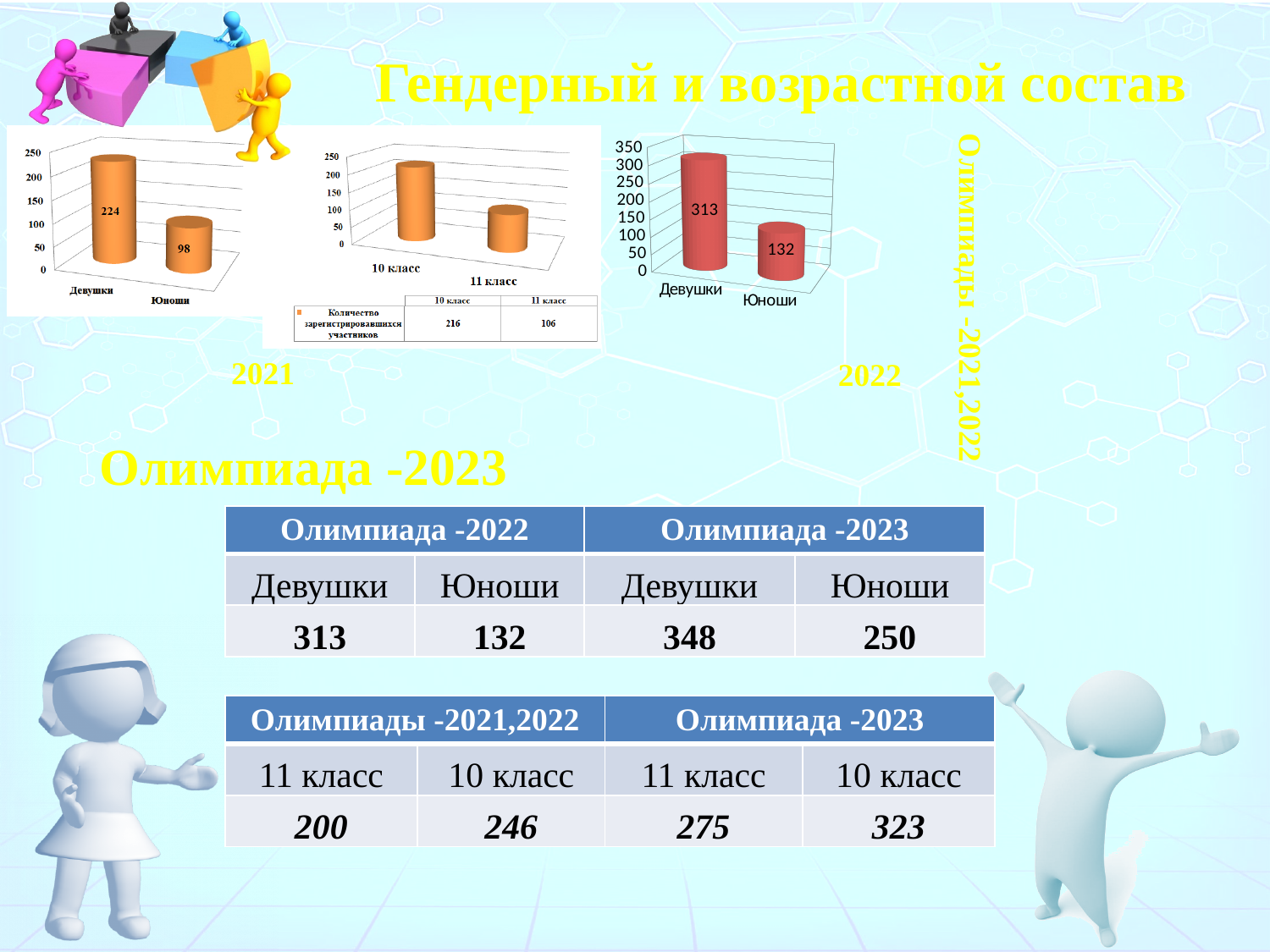
In the rightmost chart (2022), what is the value for Девушки? 313 In the middle chart, which category has the lower value? 11 класс In the leftmost chart (2021), what is the value for Девушки? 224 In the leftmost chart (2021), which category has the higher value? Девушки In the leftmost chart (2021), what is the difference between the values for Девушки and Юноши? 126 In the leftmost chart (2021), what is the value for Юноши? 98 In the middle chart, what is the value for 10 класс? 216 In the rightmost chart (2022), what is the value for Юноши? 132 In the middle chart, what is the value for 11 класс? 106 What type of chart is the rightmost chart (2022)? Bar chart In the middle chart, what is the difference between the values for 10 класс and 11 класс? 110 In the rightmost chart (2022), what is the difference between the values for Девушки and Юноши? 181